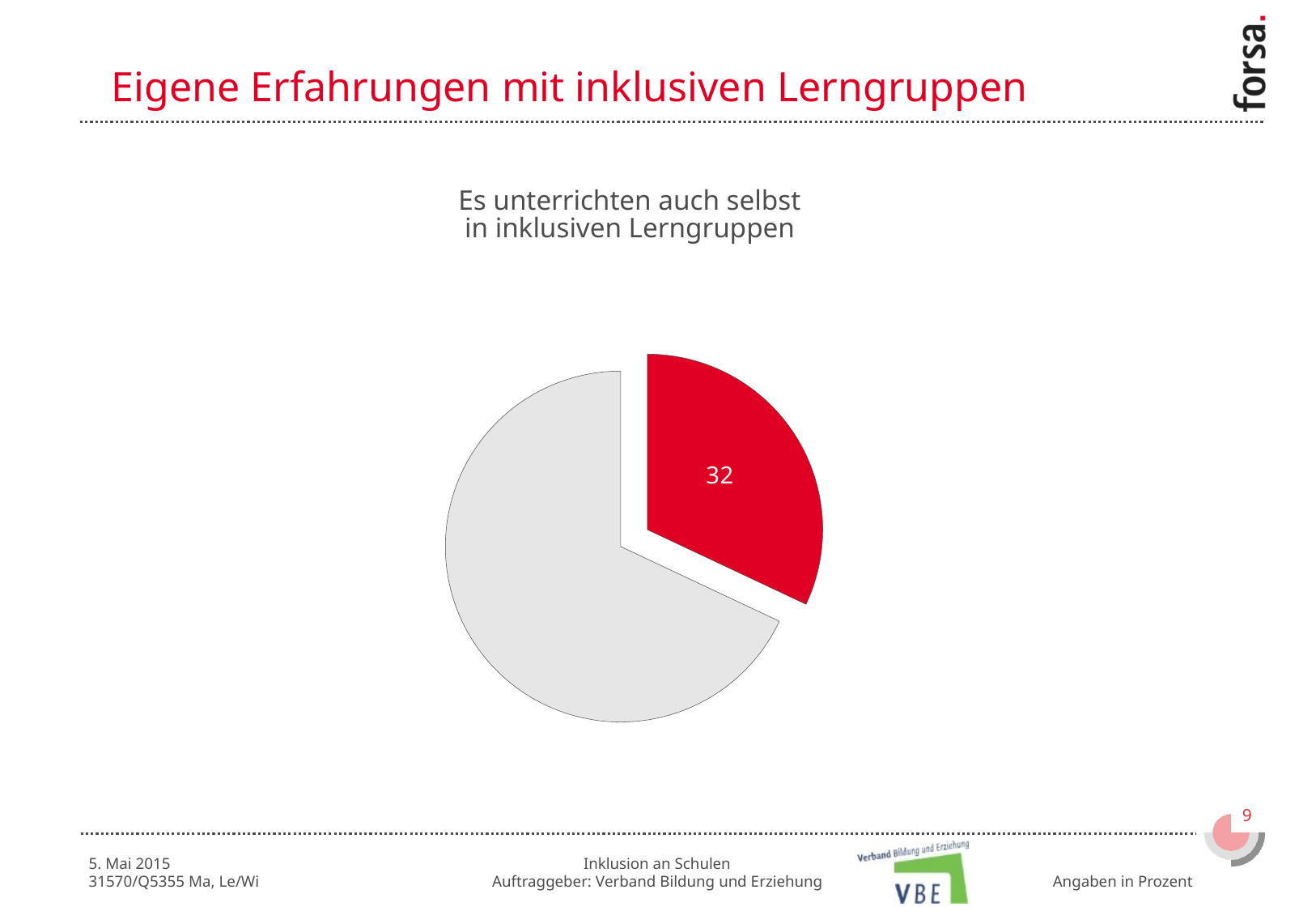
What kind of chart is shown on the slide? pie chart What share of the pie does the red slice represent, according to the label printed on it? 32 Which slice of the pie chart is the smallest? the red slice In what unit are the values on the slide given, according to the note at the bottom right? Prozent How many slices does the pie chart have? 2 What value is printed on the red slice of the pie chart? 32 Which slice of the pie chart is larger, the red slice or the grey slice? the grey slice What is the title printed above the pie chart? Es unterrichten auch selbst in inklusiven Lerngruppen